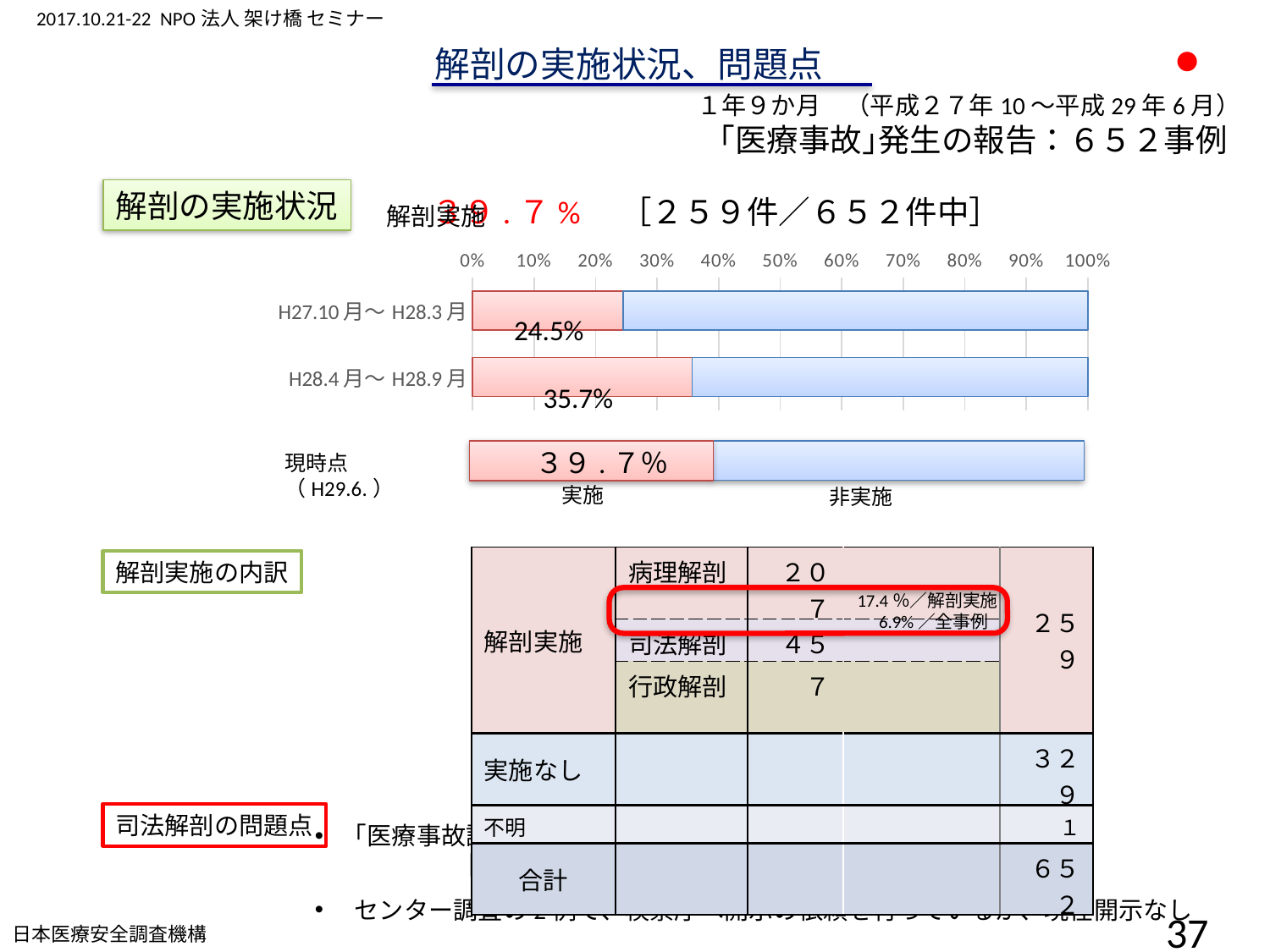
What is the 実施 value for H28.4月～H28.9月? 35.7% Does the 実施 percentage rise or fall from the earliest period to 現時点（H29.6.）? rise Which period has the highest 実施 percentage? 現時点（H29.6.） What is the 実施 value for H27.10月～H28.3月? 24.5% What is the 実施 value for 現時点（H29.6.）? 39.7% What is the difference between the 実施 values for H28.4月～H28.9月 and H27.10月～H28.3月? 11.2% How many series does the chart legend list? 2 Is the 非実施 value for H27.10月～H28.3月 greater or less than 70%? greater How many periods are shown in the bar chart? 3 What kind of chart is used to show the 解剖の実施状況? bar chart Which period has the lowest 実施 percentage? H27.10月～H28.3月 Which is larger, the 実施 value for 現時点（H29.6.） or for H28.4月～H28.9月? 現時点（H29.6.）